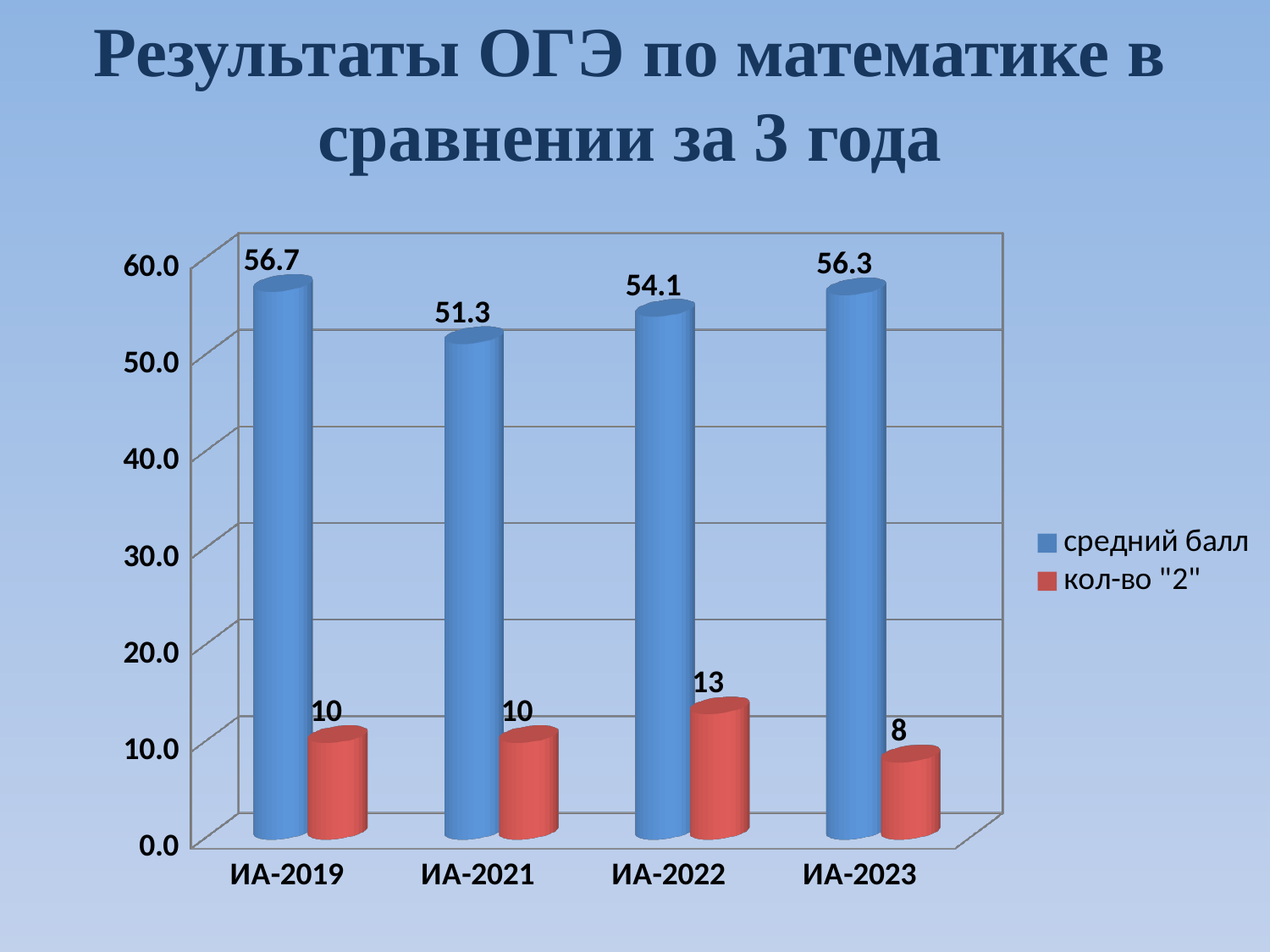
Is the средний балл for ИА-2022 greater or less than 50.0? greater What kind of chart is shown on the slide? bar chart What is the средний балл value for ИА-2021? 51.3 How many series does the legend list? 2 What is the difference between the средний балл for ИА-2019 and ИА-2021? 5.4 What colour are the bars for the series кол-во "2"? red What is the кол-во "2" value for ИА-2022? 13 Which is larger: the кол-во "2" for ИА-2022 or for ИА-2023? ИА-2022 How many categories are shown on the x axis? 4 Which category has the highest средний балл? ИА-2019 What is the средний балл value for ИА-2019? 56.7 Which category has the lowest кол-во "2"? ИА-2023